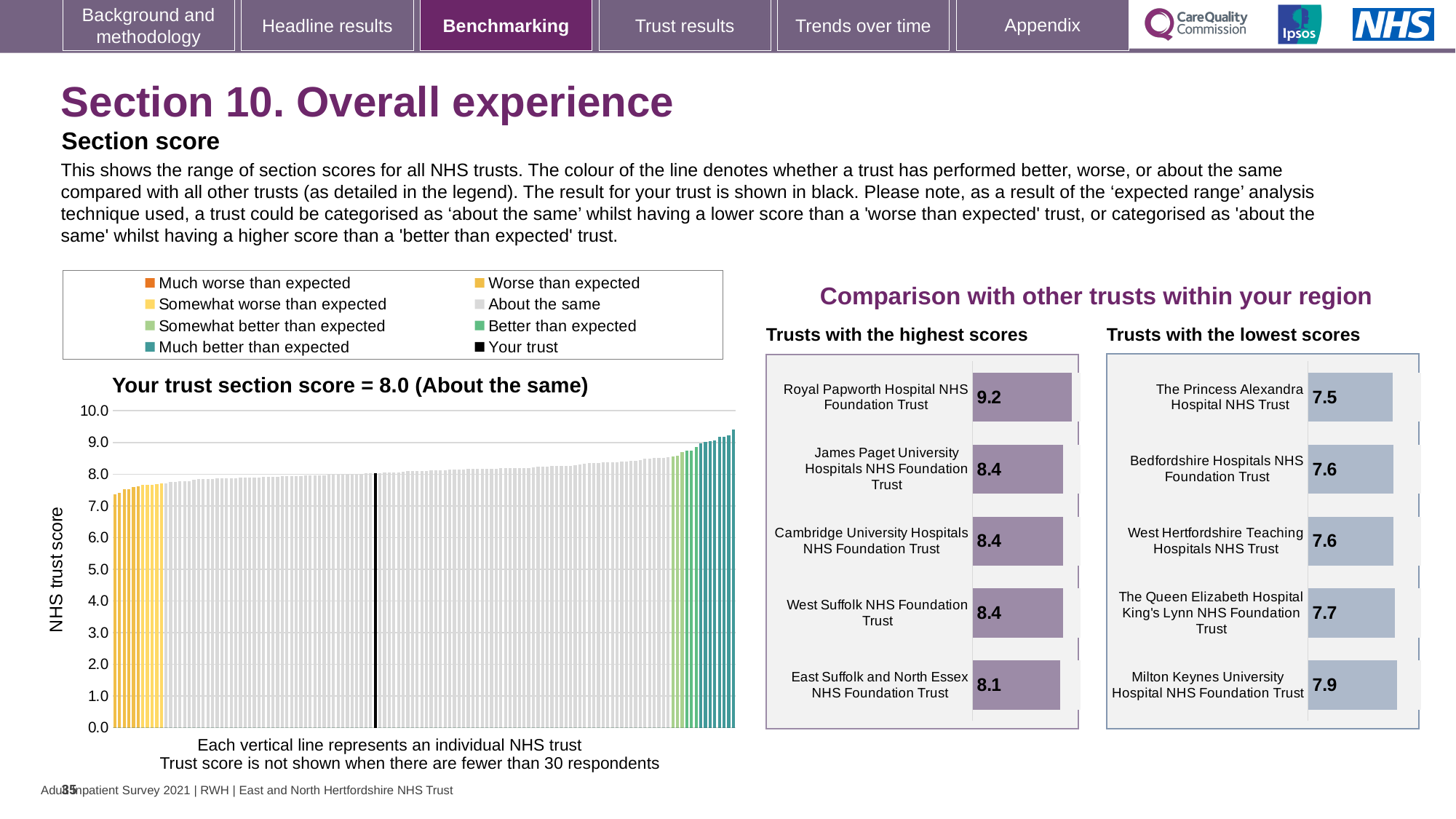
Which has a higher score: Royal Papworth Hospital NHS Foundation Trust in the highest scores chart, or Milton Keynes University Hospital NHS Foundation Trust in the lowest scores chart? Royal Papworth Hospital NHS Foundation Trust In the 'Trusts with the highest scores' chart, what is the score for East Suffolk and North Essex NHS Foundation Trust? 8.1 In the 'Trusts with the lowest scores' chart, what is the score for Milton Keynes University Hospital NHS Foundation Trust? 7.9 In the 'Trusts with the lowest scores' chart, what is the difference between the scores of Milton Keynes University Hospital NHS Foundation Trust and The Princess Alexandra Hospital NHS Trust? 0.4 In the 'Trusts with the lowest scores' chart, which trust has the lowest score? The Princess Alexandra Hospital NHS Trust What type of chart is the large chart on the left titled 'Your trust section score = 8.0 (About the same)'? Bar chart How many trusts are shown in the 'Trusts with the lowest scores' chart? 5 In the 'Trusts with the highest scores' chart, what is the score for Royal Papworth Hospital NHS Foundation Trust? 9.2 In the 'Trusts with the lowest scores' chart, what is the score for The Princess Alexandra Hospital NHS Trust? 7.5 In the 'Trusts with the highest scores' chart, which trust has the highest score? Royal Papworth Hospital NHS Foundation Trust In the large chart on the left, what is the section score for your trust, as stated in the chart title? 8.0 In the 'Trusts with the highest scores' chart, what is the difference between the scores of Royal Papworth Hospital NHS Foundation Trust and East Suffolk and North Essex NHS Foundation Trust? 1.1